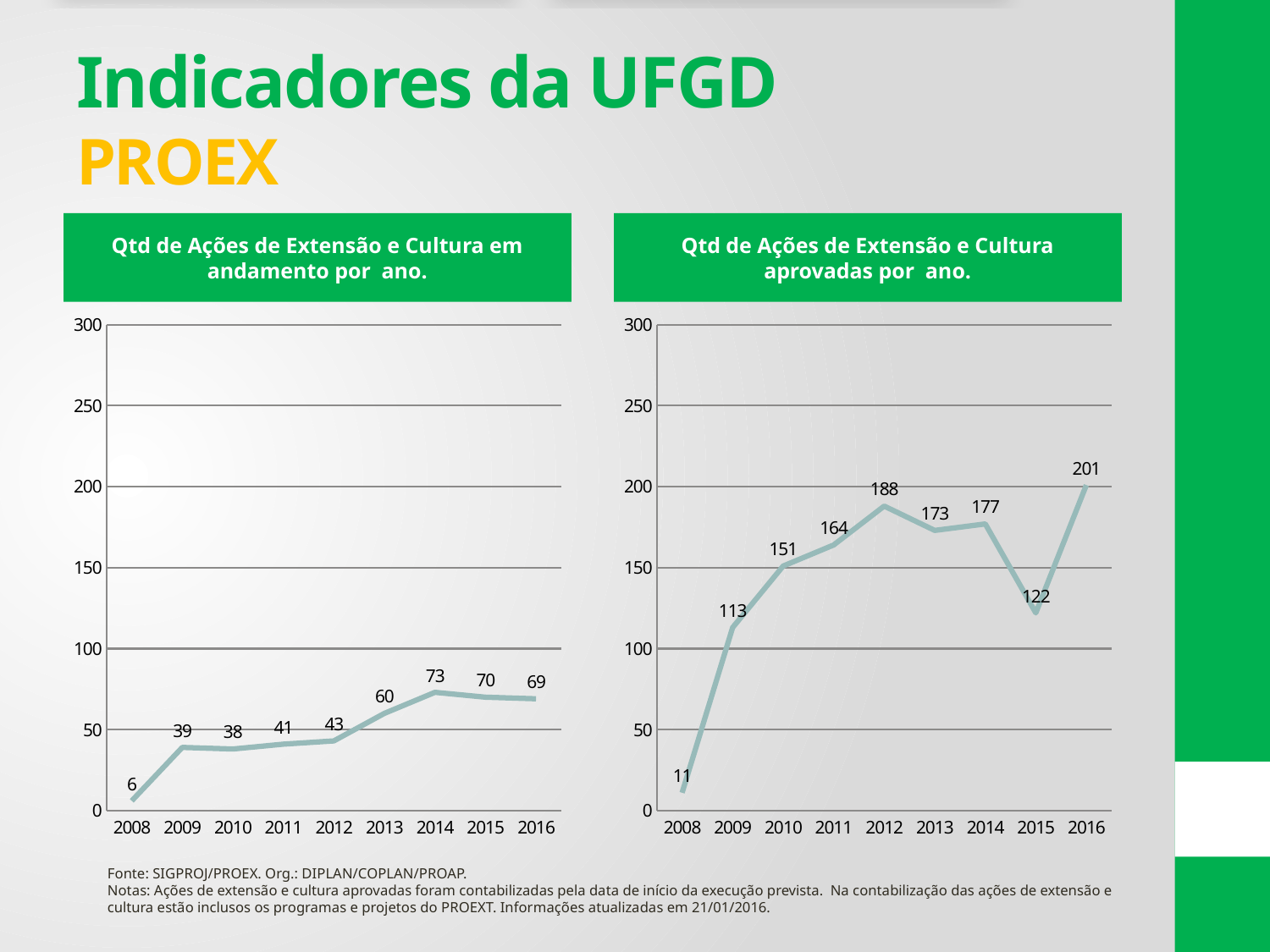
In the chart 'Qtd de Ações de Extensão e Cultura aprovadas por ano', do the values rise or fall from 2008 to 2012? Rise In the chart 'Qtd de Ações de Extensão e Cultura em andamento por ano', what is the value for 2014? 73 In the chart 'Qtd de Ações de Extensão e Cultura em andamento por ano', is the value for 2013 greater or less than 50? greater How many years are plotted in the chart 'Qtd de Ações de Extensão e Cultura aprovadas por ano'? 9 In the chart 'Qtd de Ações de Extensão e Cultura aprovadas por ano', which is larger, the value for 2012 or the value for 2014? 2012 In the chart 'Qtd de Ações de Extensão e Cultura em andamento por ano', which year has the lowest value? 2008 What kind of chart is 'Qtd de Ações de Extensão e Cultura em andamento por ano'? Line chart In the chart 'Qtd de Ações de Extensão e Cultura em andamento por ano', what is the difference between the values for 2014 and 2008? 67 What is the title of the chart on the right side of the slide? Qtd de Ações de Extensão e Cultura aprovadas por ano. In the chart 'Qtd de Ações de Extensão e Cultura aprovadas por ano', what is the difference between the values for 2016 and 2015? 79 In the chart 'Qtd de Ações de Extensão e Cultura aprovadas por ano', what is the value for 2015? 122 In the chart 'Qtd de Ações de Extensão e Cultura aprovadas por ano', which year has the highest value? 2016